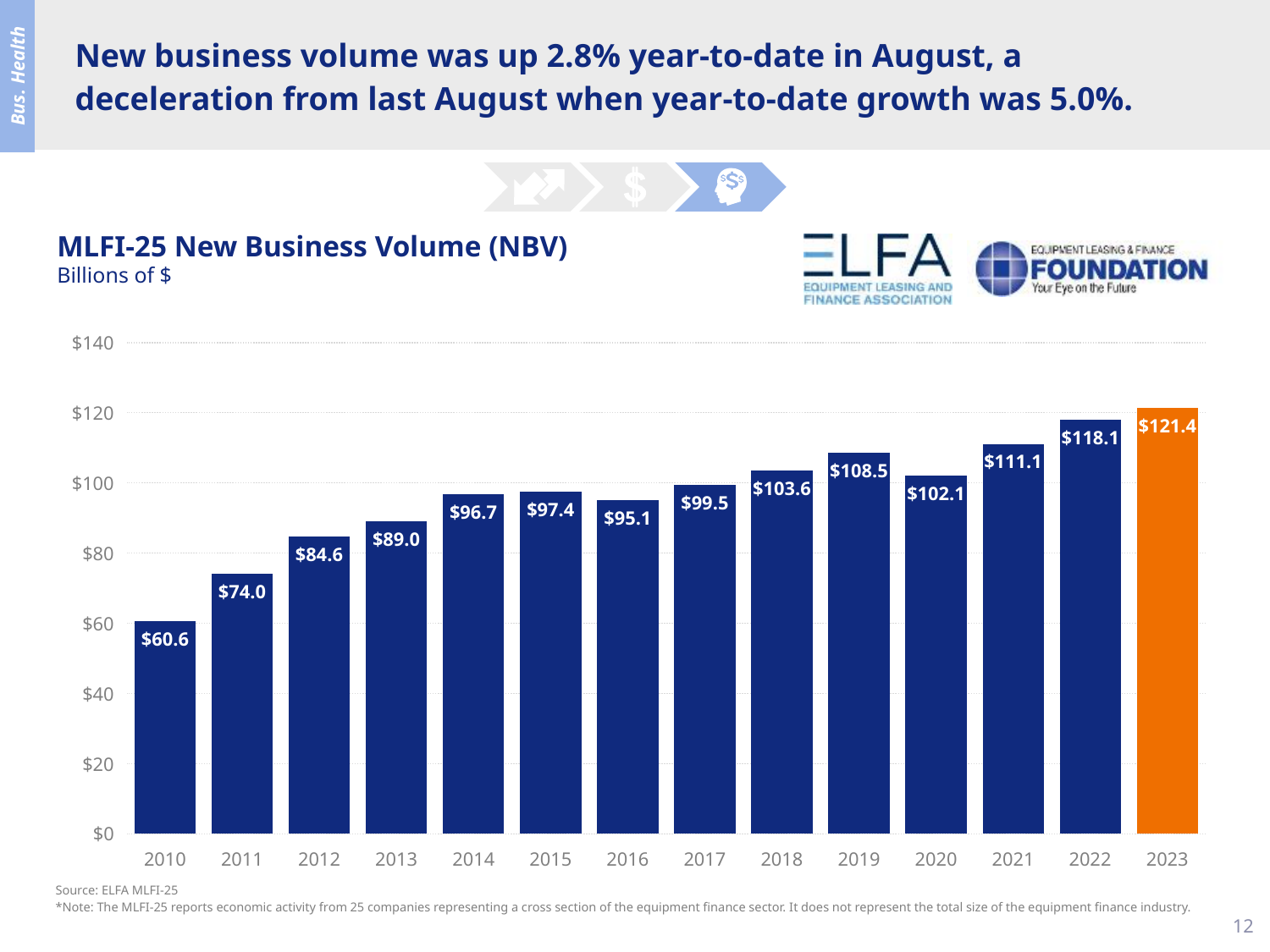
How many years are shown on the chart? 14 What is the difference between the new business volume in 2023 and in 2022? $3.3 Which year's bar is shown in orange rather than dark blue? 2023 Which year has the lowest MLFI-25 new business volume? 2010 What is the MLFI-25 new business volume for 2016? $95.1 Which year has a larger new business volume, 2019 or 2020? 2019 Which year has the highest MLFI-25 new business volume? 2023 What is the MLFI-25 new business volume for 2010? $60.6 What kind of chart is used to show MLFI-25 New Business Volume? Bar chart Do the new business volume values generally rise or fall from 2010 to 2023? Rise What is the MLFI-25 new business volume for 2020? $102.1 Is the value for 2021 greater or less than $100? greater